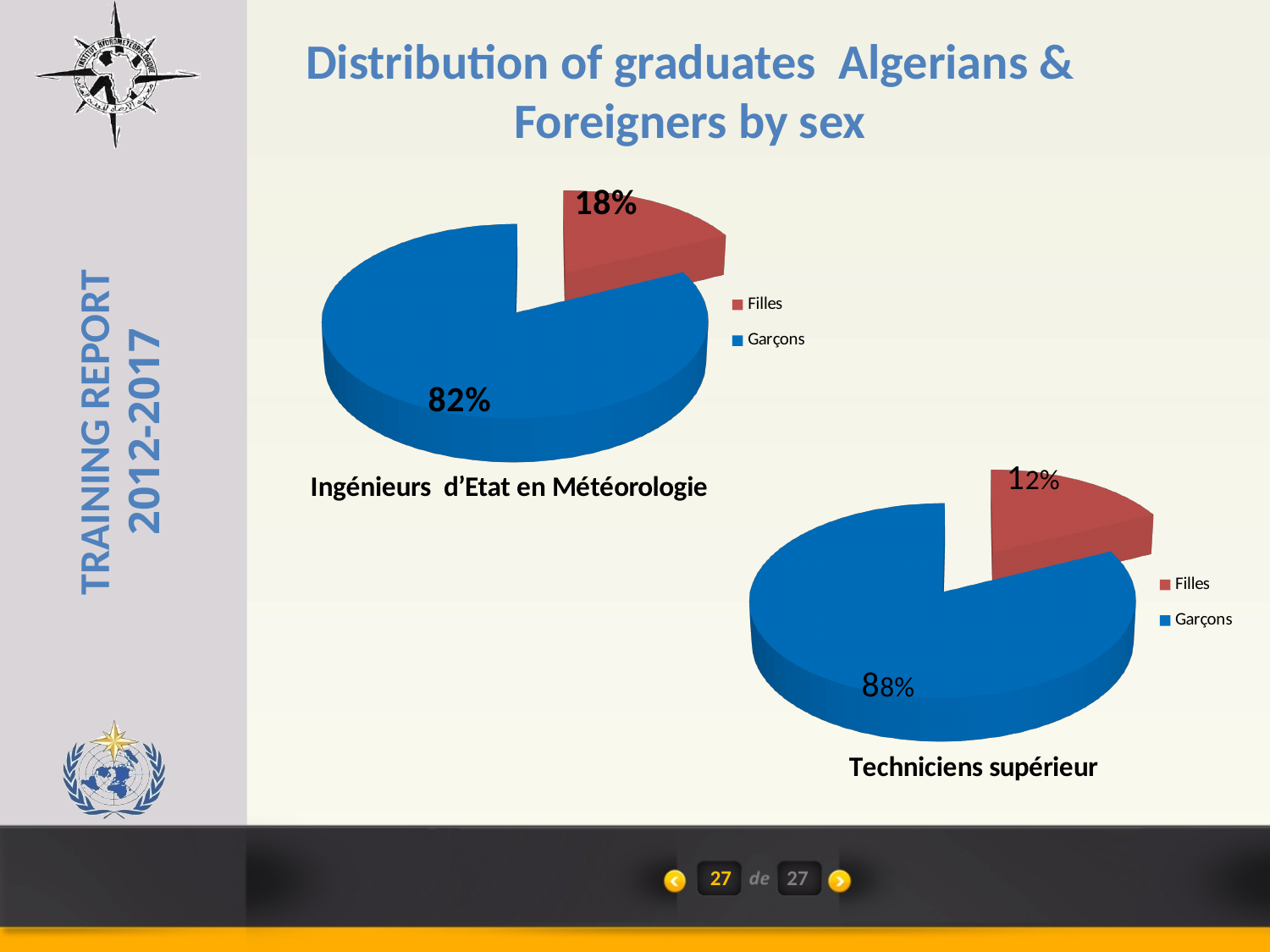
In the 'Techniciens supérieur' pie chart, what share is labelled for Filles? 12% In the 'Ingénieurs d'Etat en Météorologie' pie chart, what is the difference in percentage points between Garçons and Filles? 64 In the 'Ingénieurs d'Etat en Météorologie' pie chart, what share is labelled for Filles? 18% What kind of chart is the 'Techniciens supérieur' chart? Pie chart In the 'Techniciens supérieur' pie chart, what is the difference in percentage points between Garçons and Filles? 76 In the 'Techniciens supérieur' pie chart, what share is labelled for Garçons? 88% Which chart shows a larger share for Filles, 'Ingénieurs d'Etat en Météorologie' or 'Techniciens supérieur'? Ingénieurs d'Etat en Météorologie How many categories does the legend of the 'Ingénieurs d'Etat en Météorologie' pie chart list? 2 In the 'Ingénieurs d'Etat en Météorologie' pie chart, which category has the largest slice? Garçons In the 'Ingénieurs d'Etat en Météorologie' pie chart, what share is labelled for Garçons? 82% In the 'Techniciens supérieur' pie chart, what colour is the Garçons slice? Blue In the 'Techniciens supérieur' pie chart, which category has the smallest slice? Filles